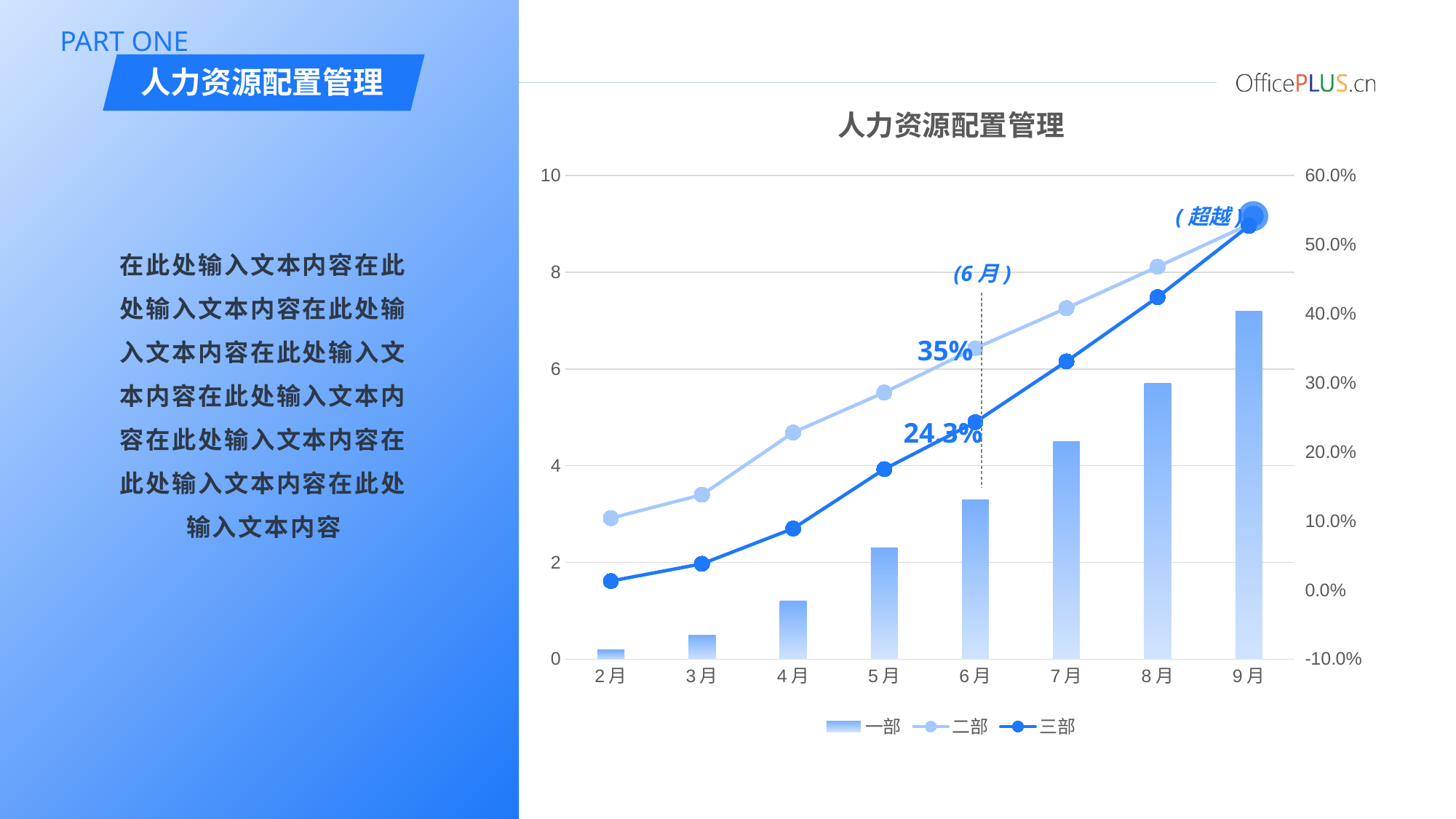
In 6月, which series has the higher value, 二部 or 三部? 二部 Which month has the highest bar for 一部? 9月 How many series does the legend list? 3 What is the value for 二部 in 6月? 35% How many months are shown on the x axis? 8 What is the title of the chart? 人力资源配置管理 Is the 一部 bar for 9月 greater or less than 6? greater What type of chart is shown on the slide? Combined bar and line chart Do the 一部 bars rise or fall from 2月 to 9月? rise What is the value for 三部 in 6月? 24.3% What is the difference between the 二部 and 三部 values in 6月? 10.7% Which month has the lowest bar for 一部? 2月